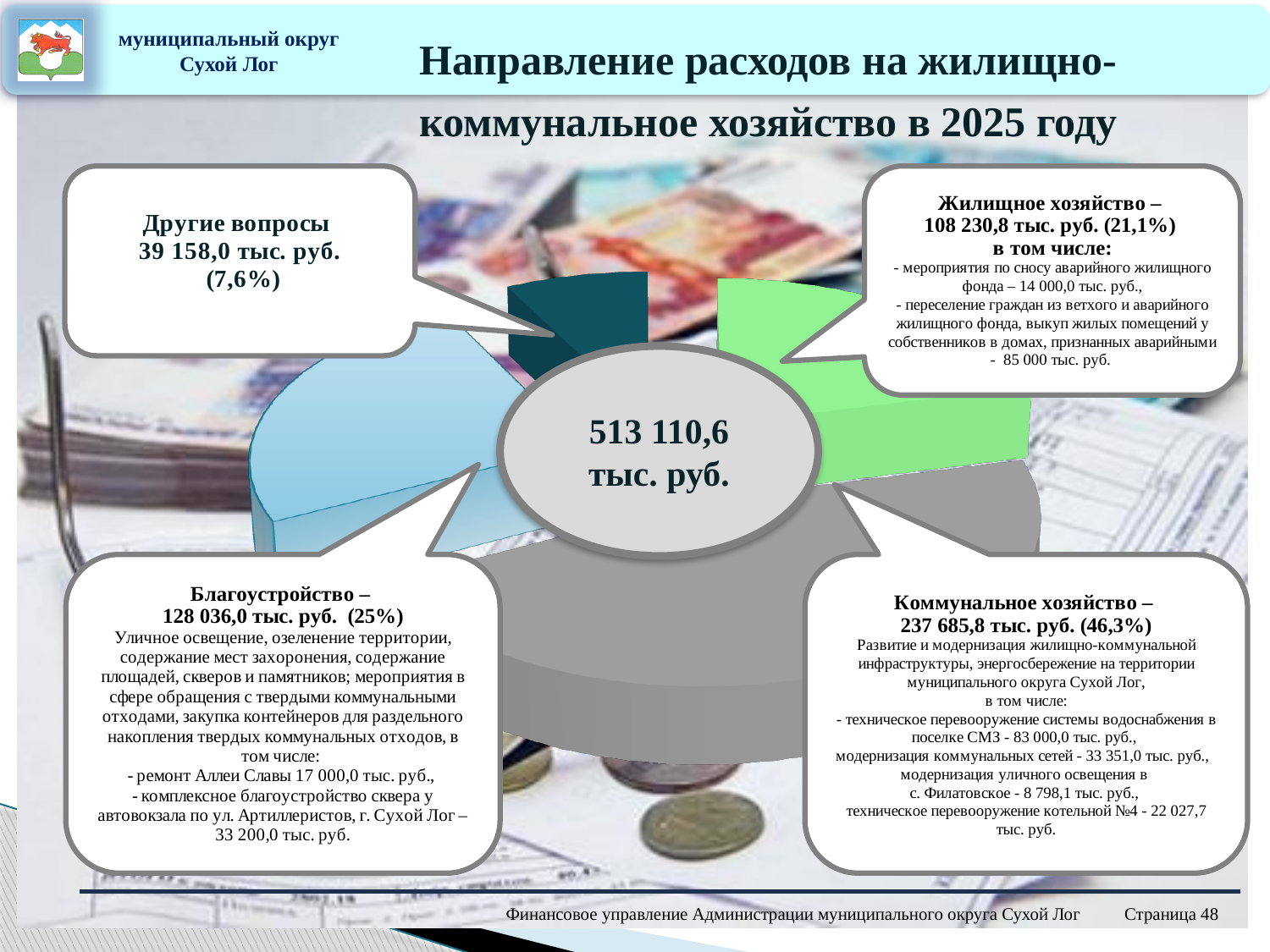
Which category has the largest share of the pie? Коммунальное хозяйство How many categories of expenditure does the pie chart show? 4 What is the total amount shown in the centre of the pie chart? 513 110,6 тыс. руб. What share of the pie does Жилищное хозяйство represent? 21,1% What is the value for Жилищное хозяйство? 108 230,8 тыс. руб. Which is larger, Благоустройство or Жилищное хозяйство? Благоустройство What is the value for Благоустройство? 128 036,0 тыс. руб. What kind of chart is shown on the slide? pie chart Which category has the smallest share of the pie? Другие вопросы What is the value for Коммунальное хозяйство? 237 685,8 тыс. руб. What share of the pie does Благоустройство represent? 25% What is the value for Другие вопросы? 39 158,0 тыс. руб.